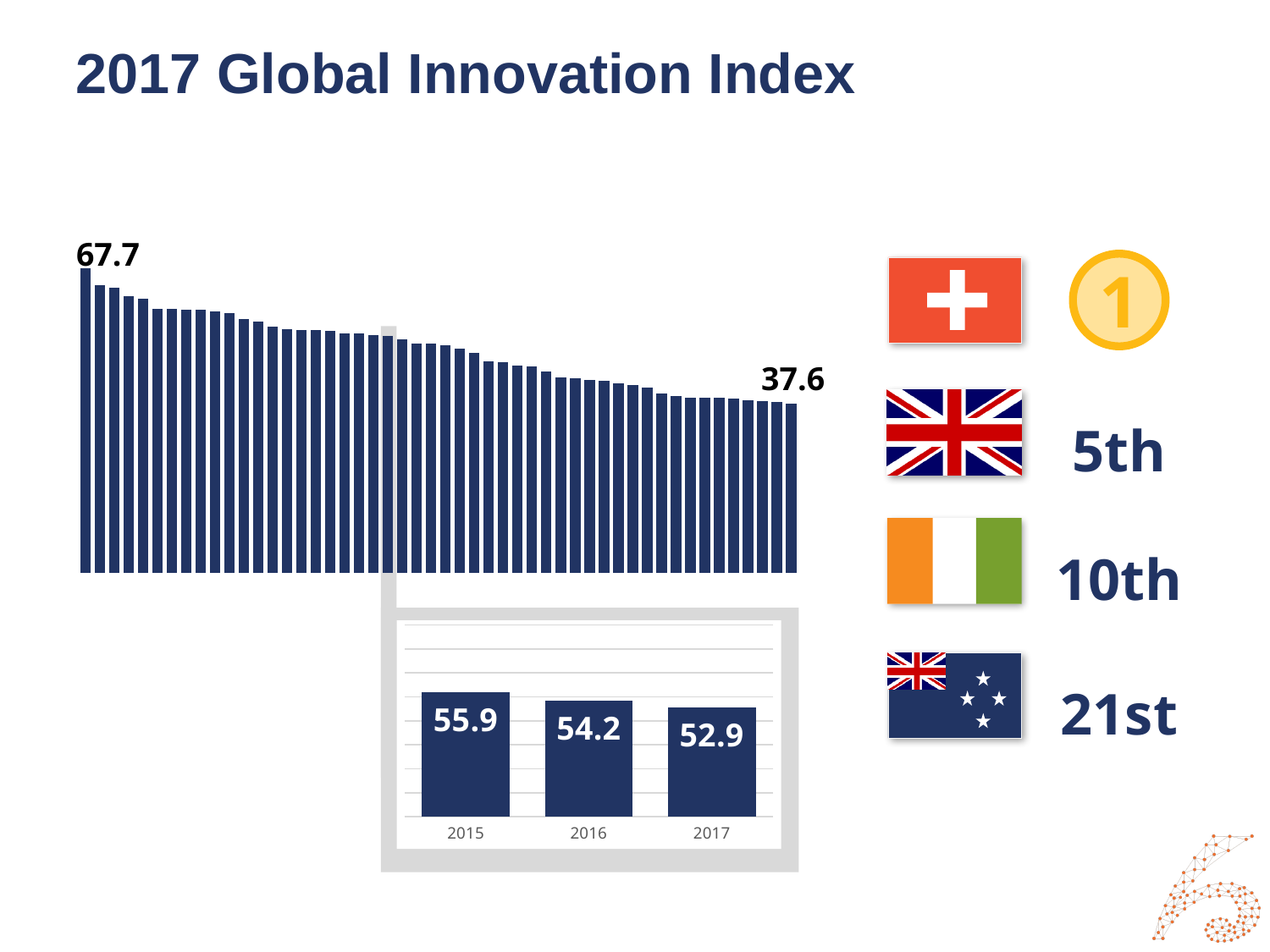
In the small inset chart at the bottom, what is the value for 2017? 52.9 In the small inset chart at the bottom, what is the value for 2016? 54.2 In the small inset chart at the bottom, which year has the highest value? 2015 What kind of chart is the large chart at the top of the slide? bar chart In the large bar chart at the top, what is the difference between the first bar's value and the last bar's value? 30.1 In the small inset chart at the bottom, which year has the lowest value? 2017 In the large bar chart at the top, what is the value labelled on the last bar? 37.6 In the small inset chart at the bottom, what is the value for 2015? 55.9 In the small inset chart at the bottom, how many years are shown? 3 In the small inset chart at the bottom, what is the difference between the 2015 and 2017 values? 3.0 In the small inset chart at the bottom, do the values rise or fall from 2015 to 2017? fall In the large bar chart at the top, what is the value labelled on the first (tallest) bar? 67.7